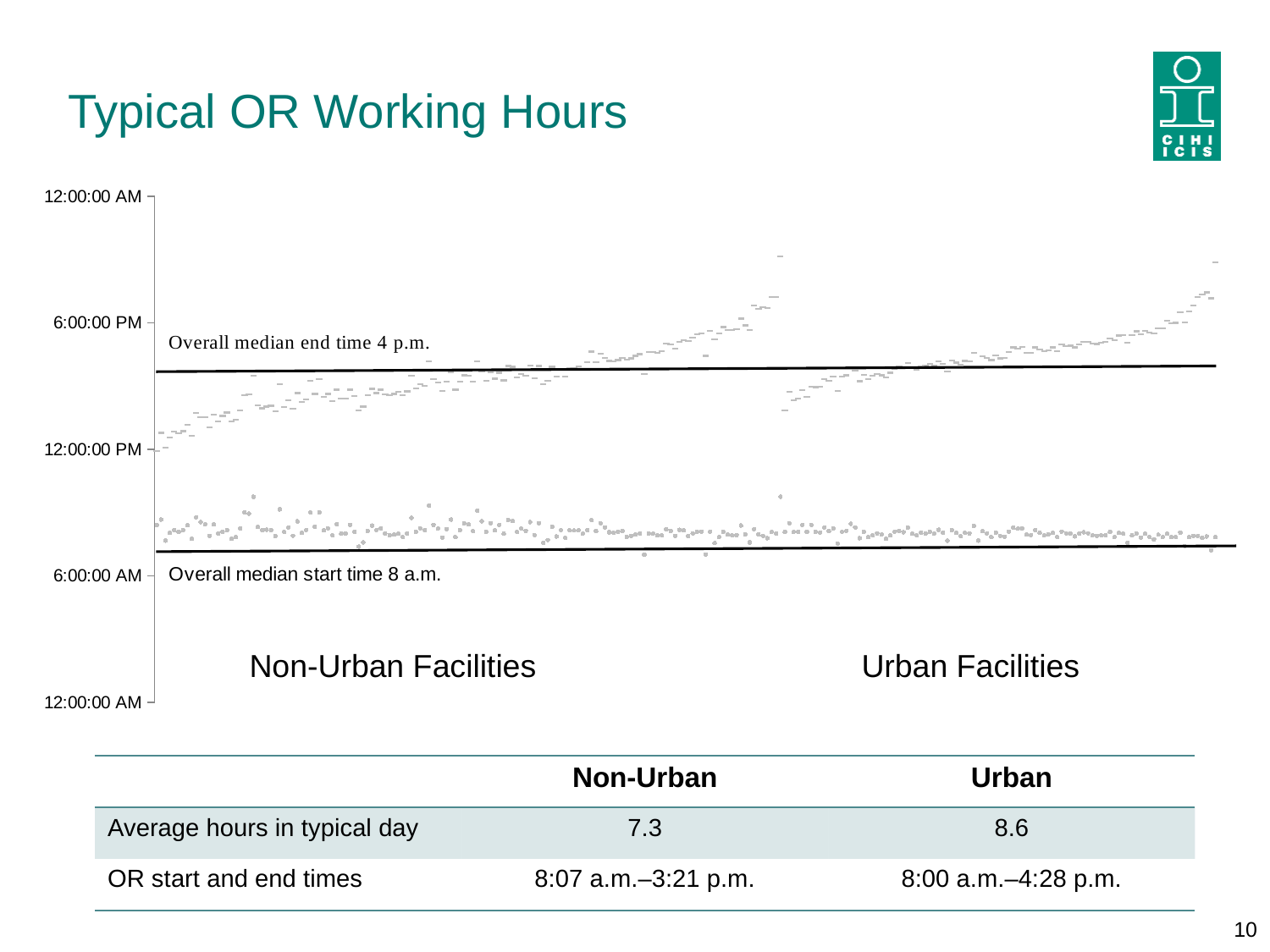
According to the annotation on the chart, what is the overall median end time? 4 p.m. What is the label at the top of the chart's y axis? 12:00:00 AM Are the start-time points for Non-Urban Facilities plotted above or below 12:00:00 PM? below Is the overall median end time line on the chart above or below the 6:00:00 PM tick? below What is the title of the chart on the slide? Typical OR Working Hours Is the overall median start time line on the chart above or below the 6:00:00 AM tick? above What kind of chart is shown on the slide? scatter chart Do the end-time points for Non-Urban Facilities rise or fall from left to right across the chart? rise According to the annotation on the chart, what is the overall median start time? 8 a.m. How many facility groups are labelled along the x axis of the chart? 2 What are the two facility groups labelled on the chart's x axis? Non-Urban Facilities and Urban Facilities